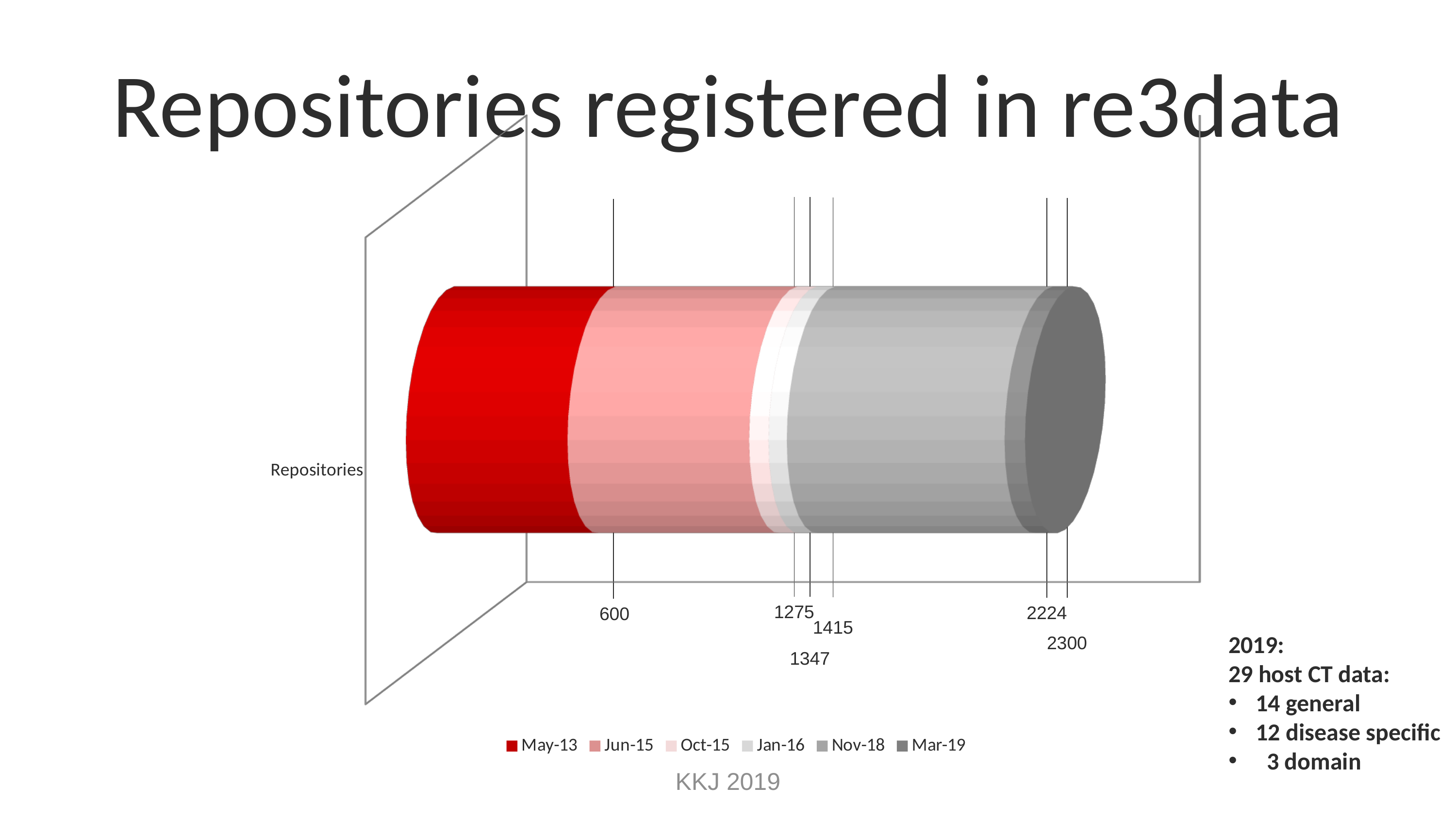
What kind of chart is shown on the slide? Bar chart What is the difference between the Jun-15 value and the May-13 value? 675 How many series does the legend list? 6 What is the value for Mar-19? 2300 What is the value for May-13? 600 What is the value for Jan-16? 1415 What is the difference between the Mar-19 value and the Nov-18 value? 76 What is the value for Nov-18? 2224 What is the title of the chart? Repositories registered in re3data